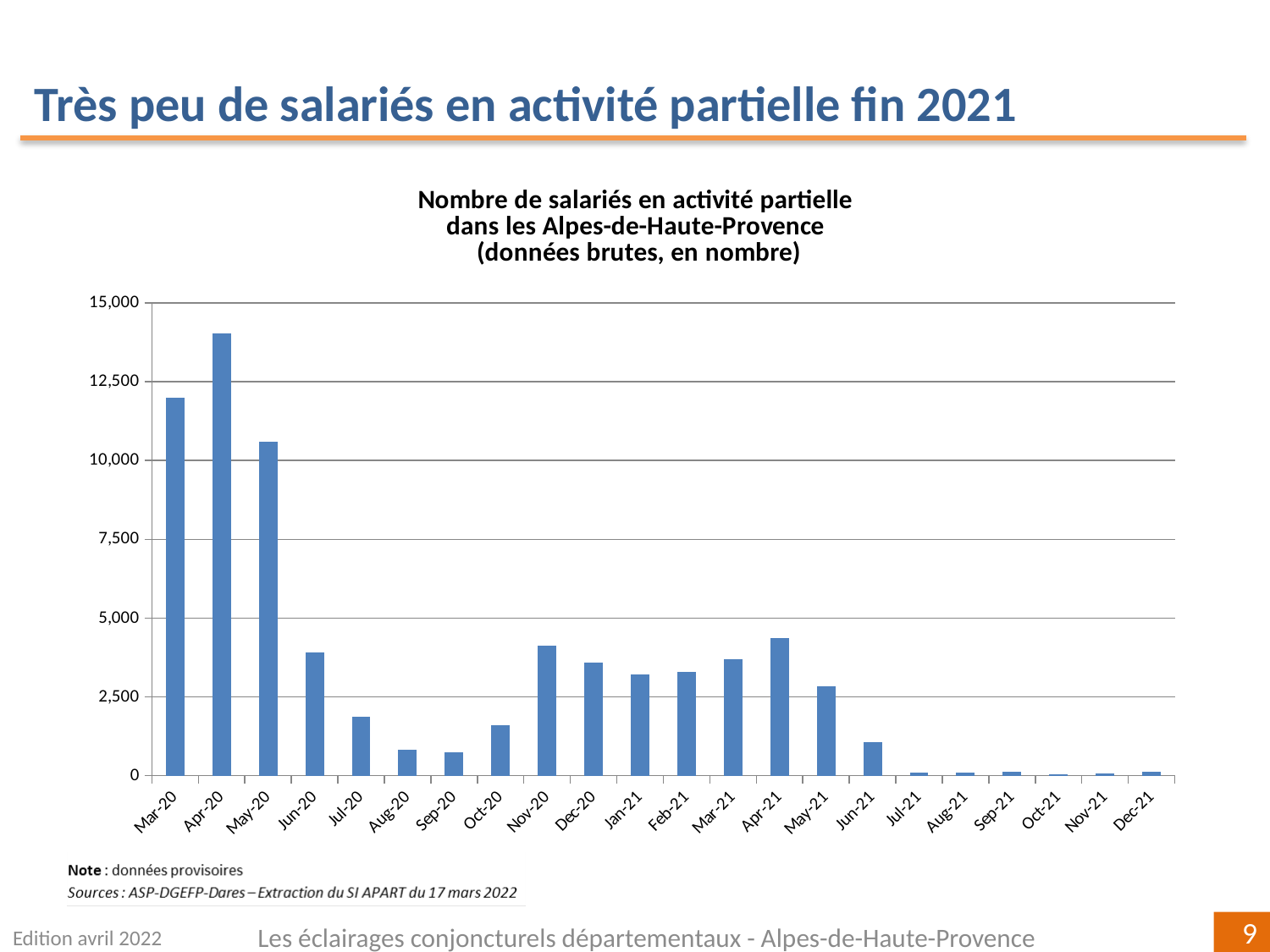
Do the values rise or fall from Mar-20 to Sep-20? fall Is the value for Mar-20 greater or less than 10,000? greater Which month has the highest number of salariés en activité partielle? Apr-20 How many months are plotted on the x axis of the chart? 22 Is the value for Jun-20 greater or less than 5,000? less What kind of chart is shown on the slide? bar chart What is the title of the chart? Nombre de salariés en activité partielle dans les Alpes-de-Haute-Provence (données brutes, en nombre) Which is larger, the value for Apr-21 or the value for May-21? Apr-21 Is the value for Apr-20 greater or less than 12,500? greater Which is larger, the value for Mar-20 or the value for May-20? Mar-20